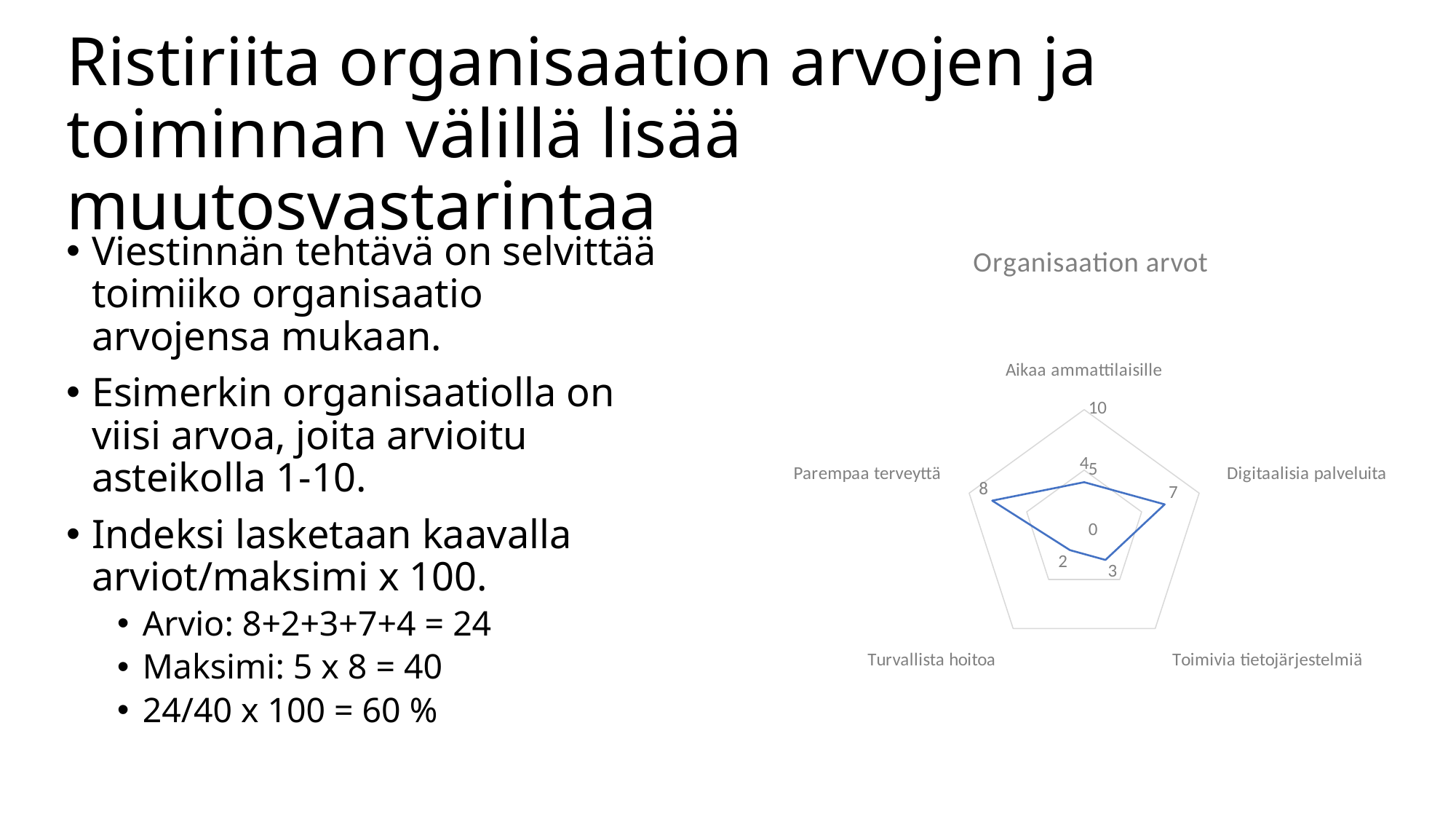
What is the title of the chart? Organisaation arvot What is the value for Turvallista hoitoa? 2 What is the difference between the values for Parempaa terveyttä and Turvallista hoitoa? 6 What is the value for Digitaalisia palveluita? 7 How many categories does the radar chart have? 5 Which category has the lowest value? Turvallista hoitoa Is the value for Parempaa terveyttä greater or less than 5? greater Which category has the highest value? Parempaa terveyttä What kind of chart is shown on the slide? radar chart What is the value for Toimivia tietojärjestelmiä? 3 What is the value for Parempaa terveyttä? 8 Which is larger, the value for Digitaalisia palveluita or the value for Toimivia tietojärjestelmiä? Digitaalisia palveluita